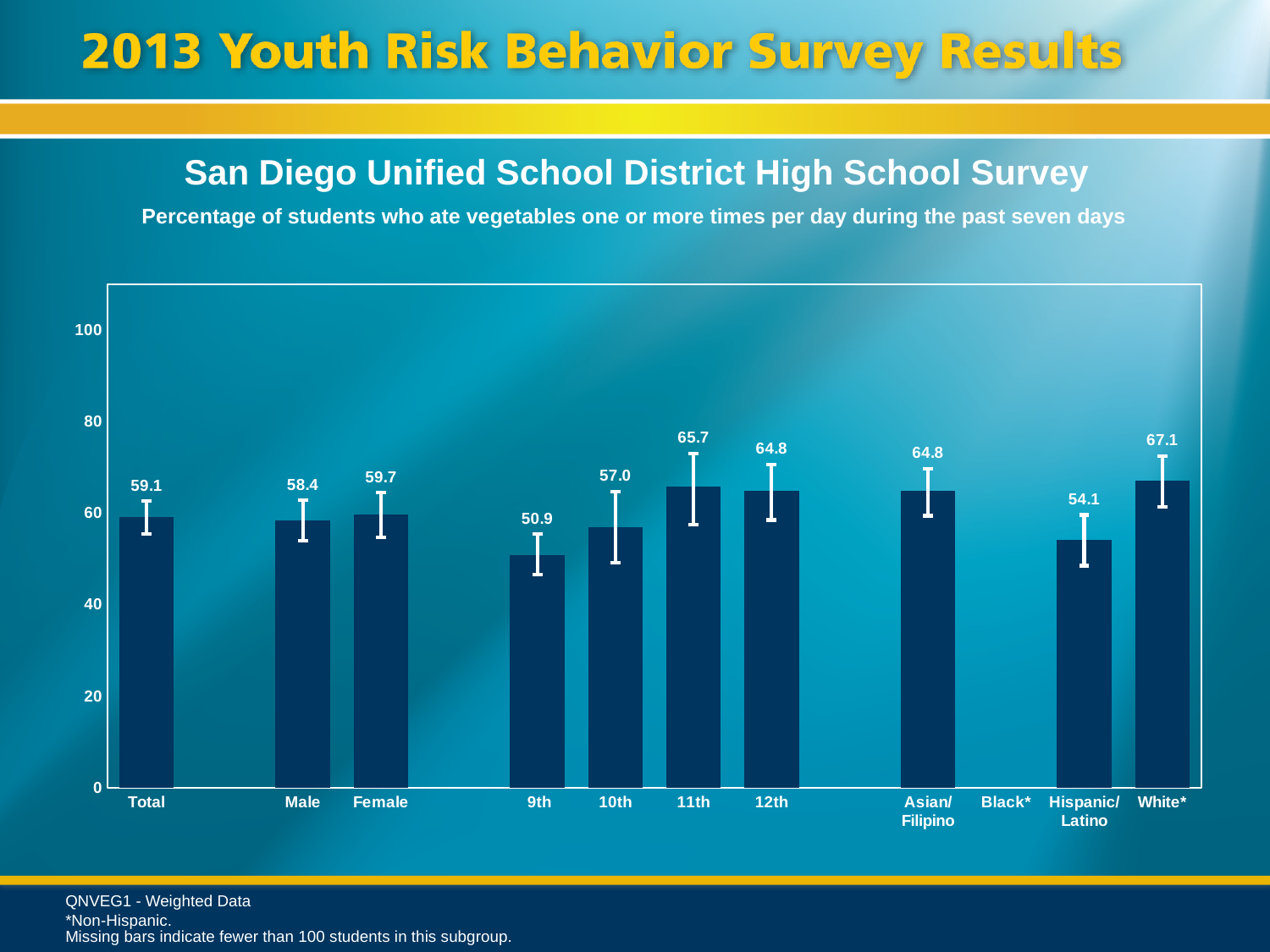
Which is larger, the value for 11th grade or the value for 10th grade? 11th What is the difference between the values for 11th and 9th grade? 14.8 Is the value for White* greater or less than 60? greater What is the difference between the values for Female and Male? 1.3 What kind of chart is shown on the slide? bar chart Which category has the highest value? White* How many bars are plotted on the chart? 10 Which category has no bar shown on the chart? Black* Which category has the lowest value among the bars shown? 9th What is the value for Total? 59.1 What is the value for 9th grade? 50.9 What is the value for Hispanic/Latino students? 54.1